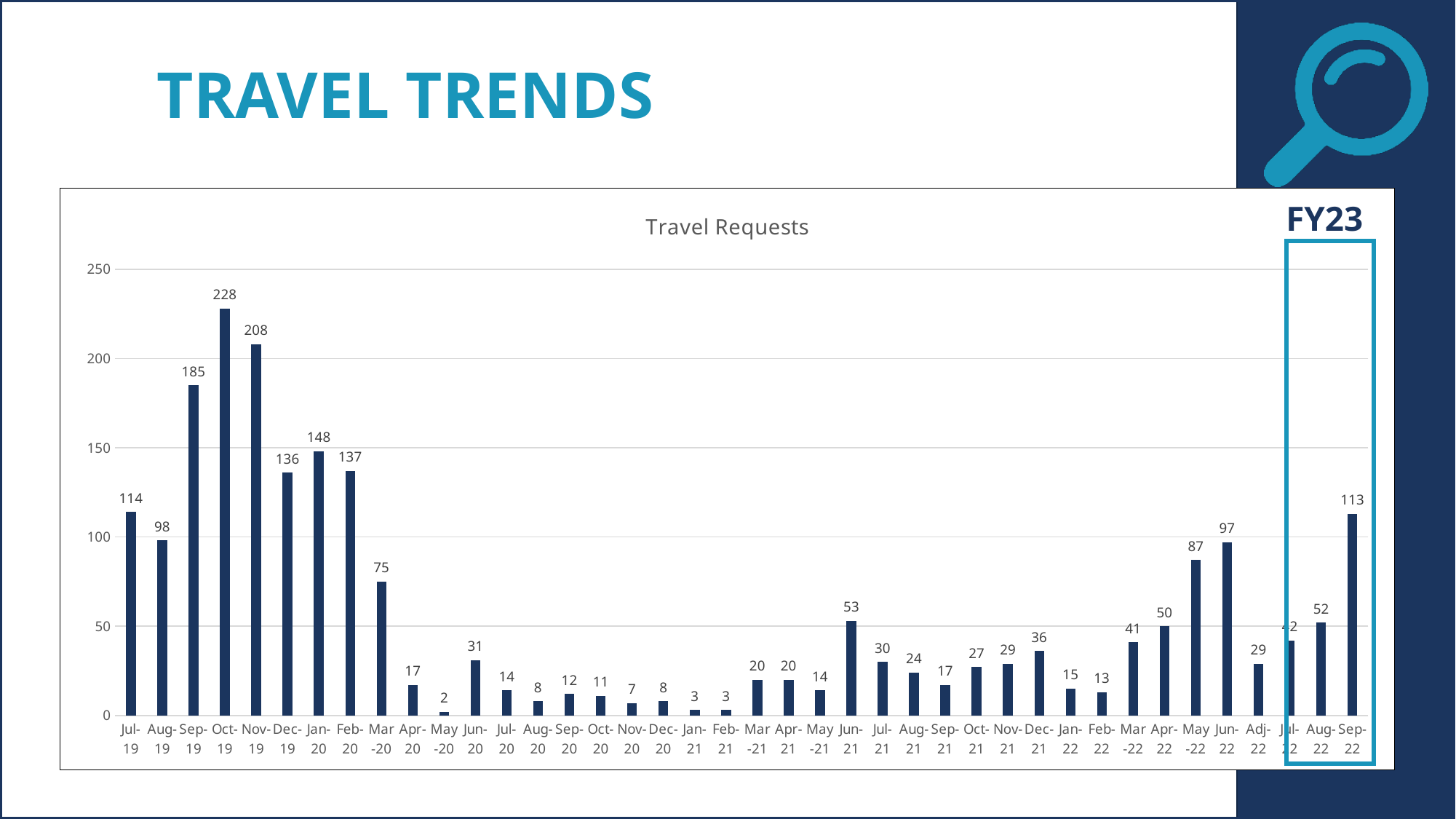
What is the difference in travel requests between Sep-22 and Aug-22? 61 What type of chart is shown on the slide? bar chart What is the value of travel requests for Jun-21? 53 Which month has the lowest number of travel requests? May-20 What is the value of travel requests for Sep-22? 113 Which month has the highest number of travel requests? Oct-19 What is the chart title? Travel Requests What is the value of travel requests for Oct-19? 228 What is the difference in travel requests between Oct-19 and Nov-19? 20 How many months (bars) are plotted in the chart? 40 Which label is shown above the highlighted box around the last three bars? FY23 Which month has more travel requests, Jun-22 or May-22? Jun-22